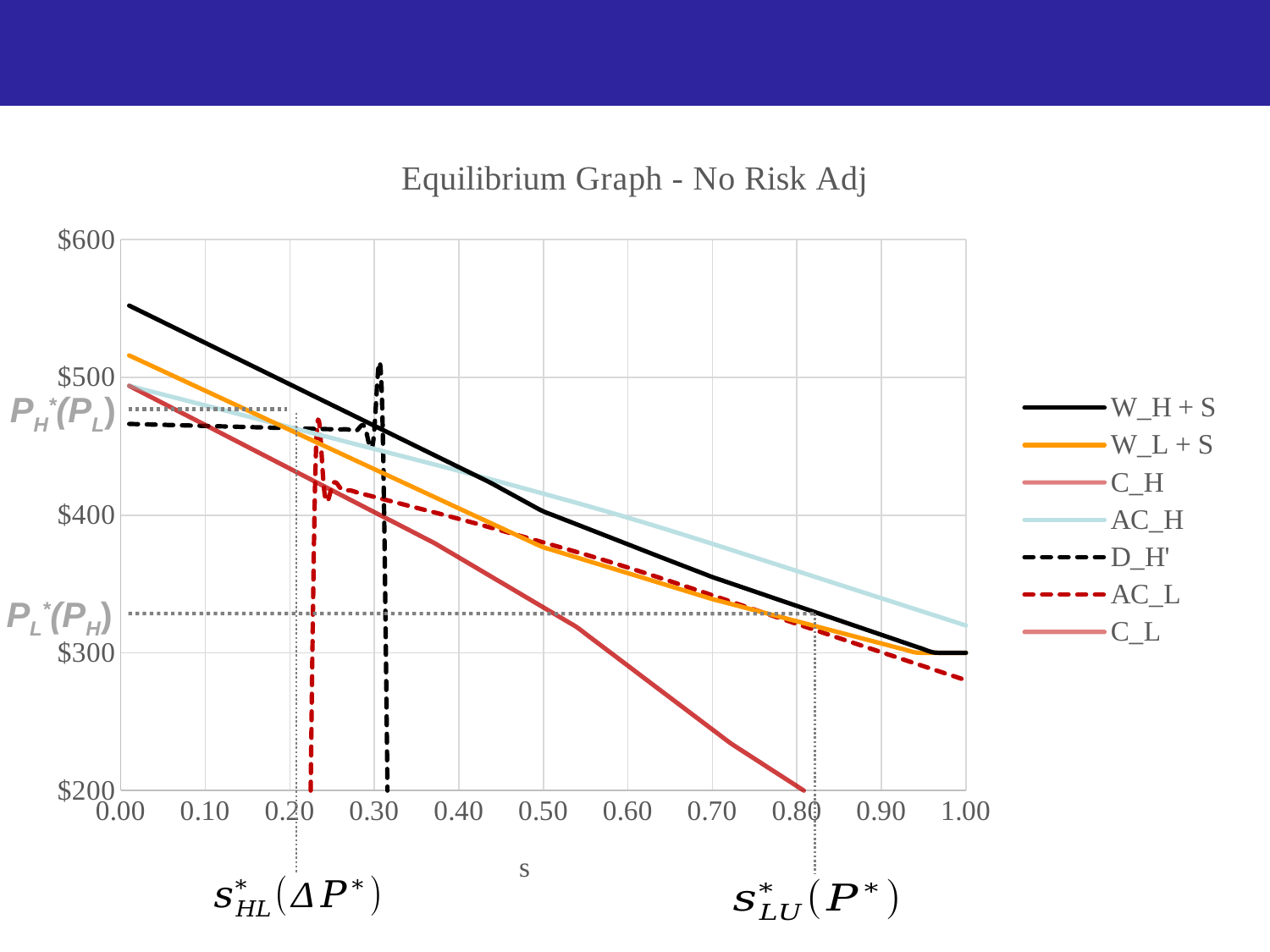
What kind of chart is shown on the slide? line chart Is the value of C_L at s = 0.40 greater or less than $400? less How many series does the legend list? 7 What is the label of the x axis? s Is the value of W_H + S at s = 0.00 greater or less than $500? greater Is the value of AC_H at s = 1.00 greater or less than $300? greater Which series has the highest value at s = 0.00? W_H + S What is the title of the chart? Equilibrium Graph - No Risk Adj At s = 0.60, which is higher, AC_H or C_L? AC_H